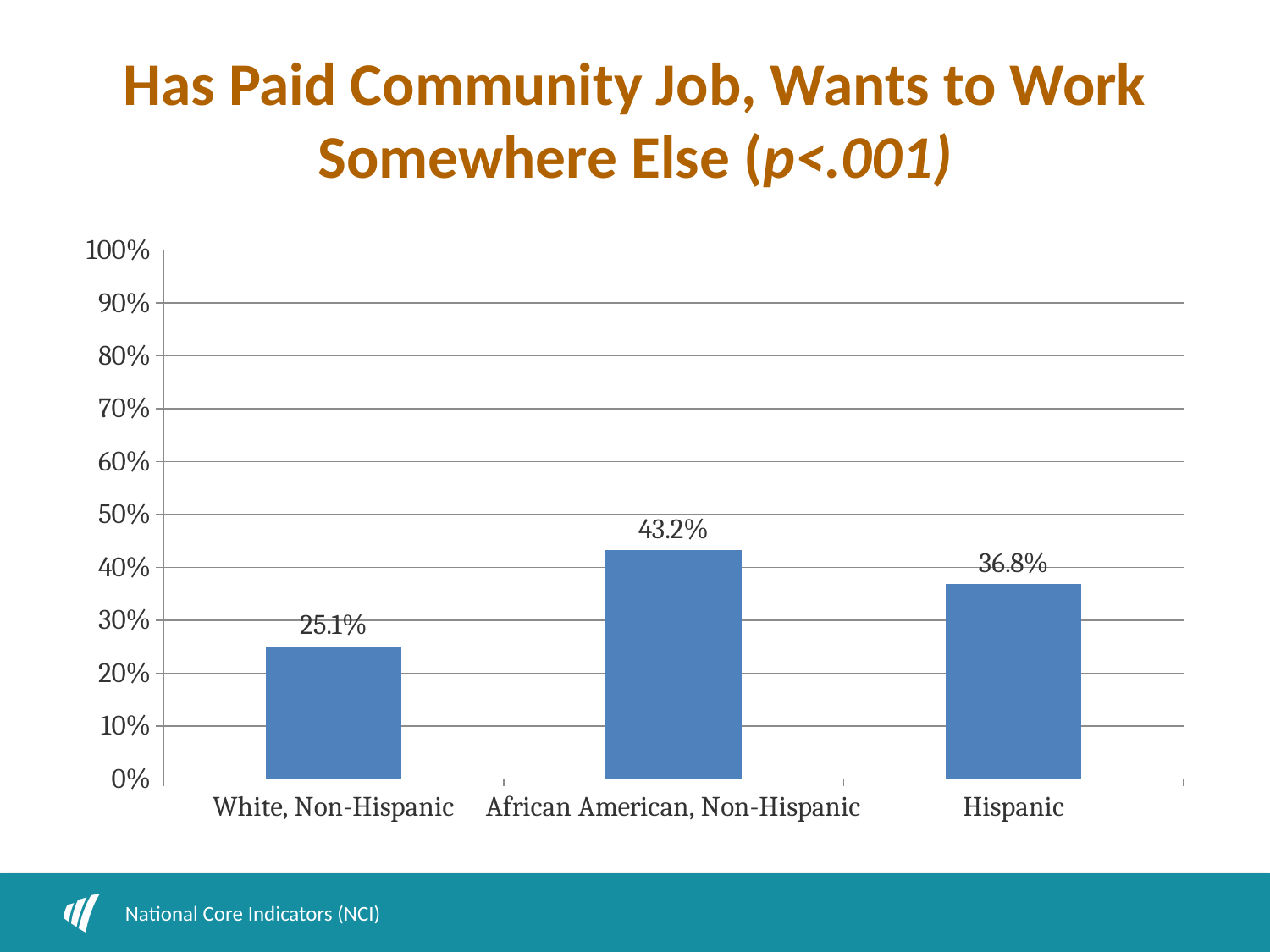
Which category has the highest value? African American, Non-Hispanic What is the value for African American, Non-Hispanic? 43.2% What is the title of the chart? Has Paid Community Job, Wants to Work Somewhere Else (p<.001) What is the difference between the values for African American, Non-Hispanic and White, Non-Hispanic? 18.1% Is the value for Hispanic greater or less than 40%? less What is the difference between the values for African American, Non-Hispanic and Hispanic? 6.4% What kind of chart is shown on the slide? bar chart Which is larger, the value for Hispanic or the value for White, Non-Hispanic? Hispanic Which category has the lowest value? White, Non-Hispanic How many categories are shown on the x axis? 3 What is the value for Hispanic? 36.8% What is the value for White, Non-Hispanic? 25.1%